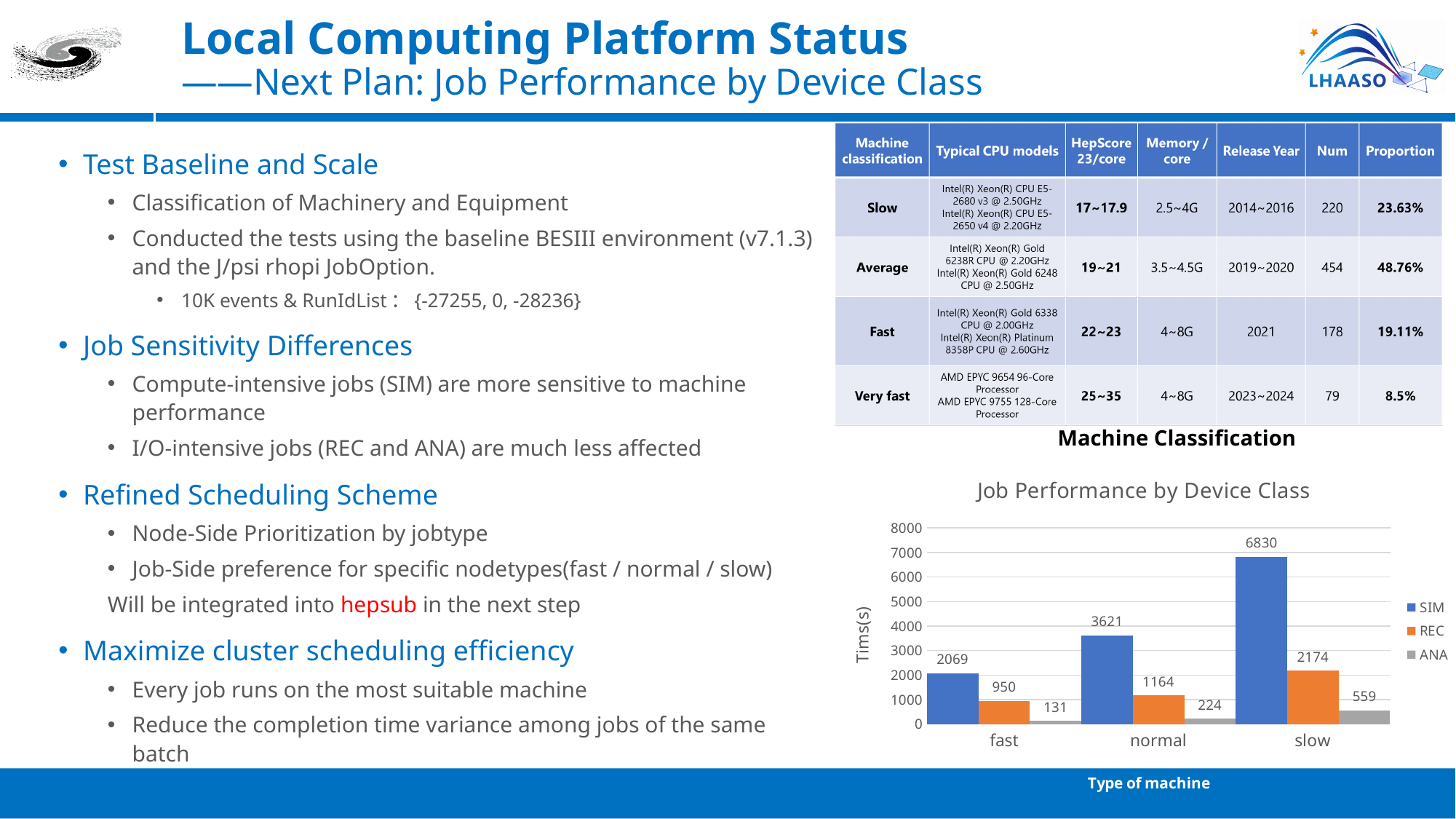
What is the ANA value for the fast machine type? 131 What kind of chart is Job Performance by Device Class? bar chart How many machine types are shown on the x axis of the chart? 3 Which is larger: the REC value for slow machines or the SIM value for fast machines? REC value for slow machines What is the REC value for the normal machine type? 1164 Do the SIM values rise or fall from fast to slow along the x axis? rise How many series does the chart legend list? 3 What is the difference between the SIM values for slow and fast machines? 4761 Which machine type has the lowest ANA value? fast What is the SIM value for the slow machine type in the Job Performance by Device Class chart? 6830 Which machine type has the highest SIM value? slow Is the SIM value for normal machines greater or less than 3000? greater